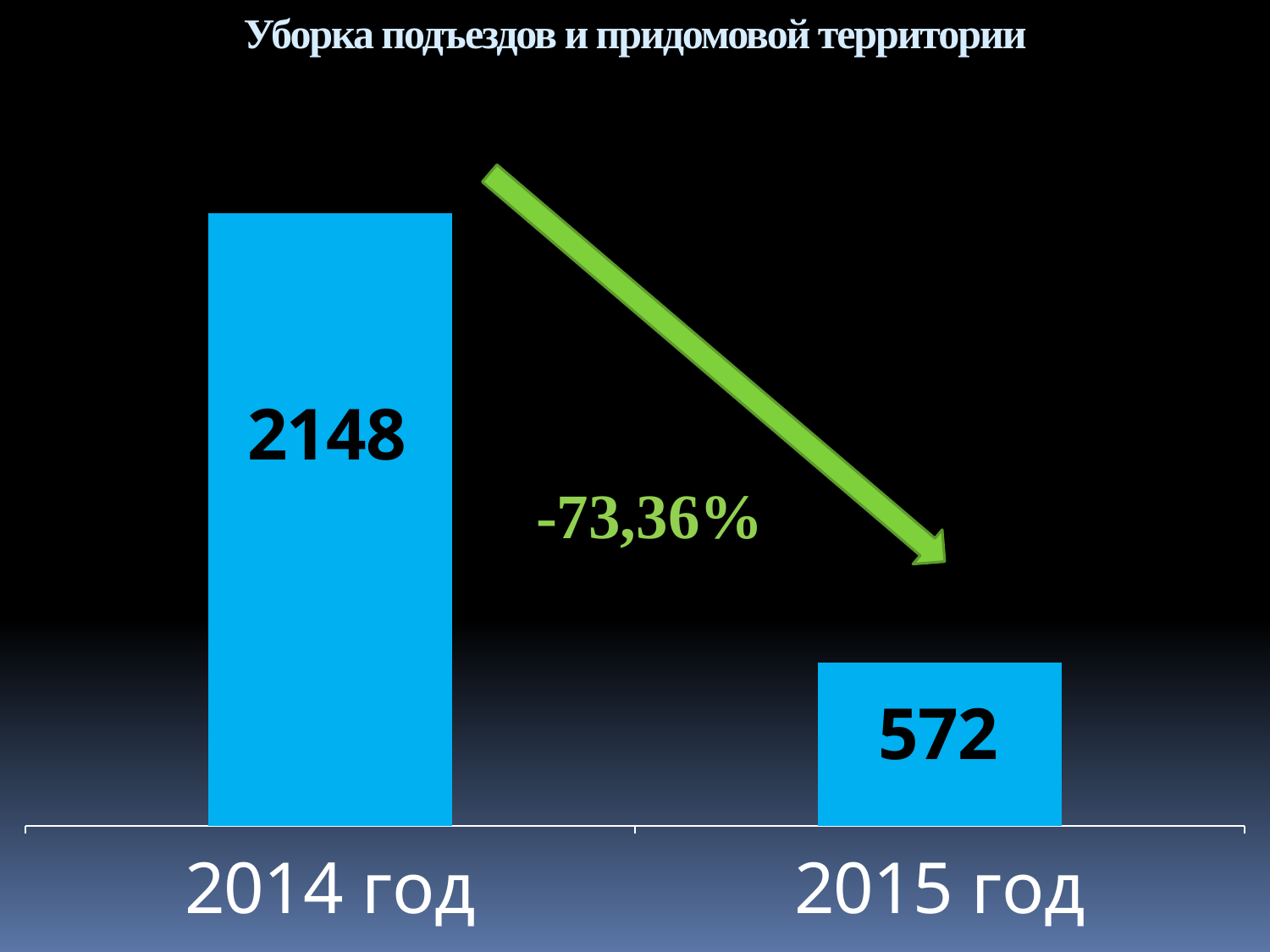
What is the value for 2015 год? 572 How many categories are shown on the chart? 2 Do the values rise or fall from 2014 год to 2015 год? Fall What percentage change is printed next to the green arrow? -73,36% What kind of chart is shown on the slide? Bar chart Which year has the highest value? 2014 год Which year has the lowest value? 2015 год What is the title of the chart? Уборка подъездов и придомовой территории What is the value for 2014 год? 2148 Which is larger, the value for 2014 год or for 2015 год? 2014 год What is the difference between the values for 2014 год and 2015 год? 1576